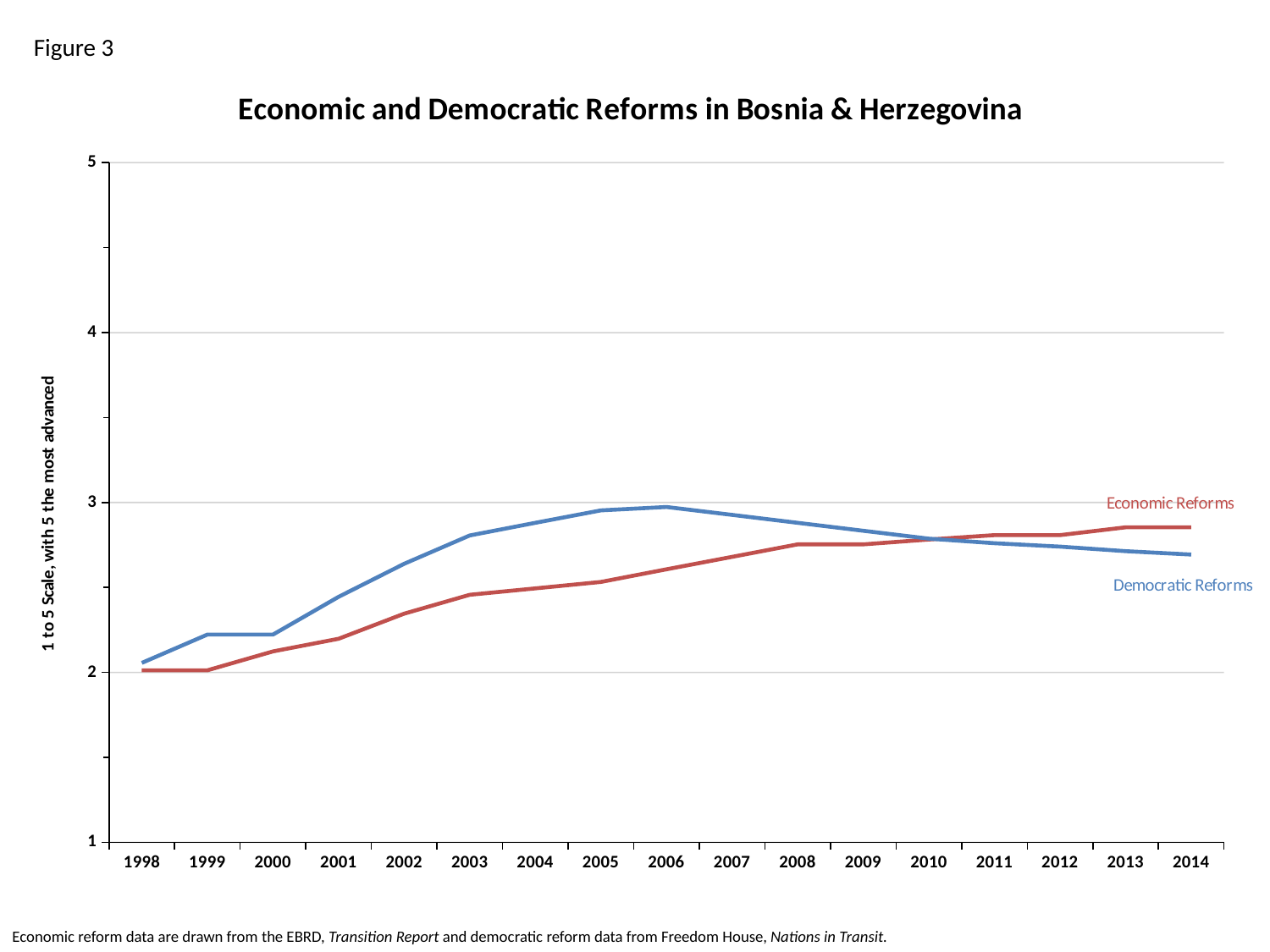
How many years are plotted along the x axis? 17 What kind of chart is shown on the slide? line chart How many series does the chart show? 2 Is the value for Democratic Reforms in 2003 greater or less than 2? greater Does the Democratic Reforms line rise or fall from 2006 to 2014? fall Is the value for Economic Reforms in 2014 greater or less than 3? less Is the value for Democratic Reforms in 1998 greater or less than 3? less What is the title of the chart? Economic and Democratic Reforms in Bosnia & Herzegovina What colour is the Economic Reforms line? red In 2003, which series has the higher value, Economic Reforms or Democratic Reforms? Democratic Reforms In 2014, which series has the higher value, Economic Reforms or Democratic Reforms? Economic Reforms In which year is the Democratic Reforms value lowest? 1998